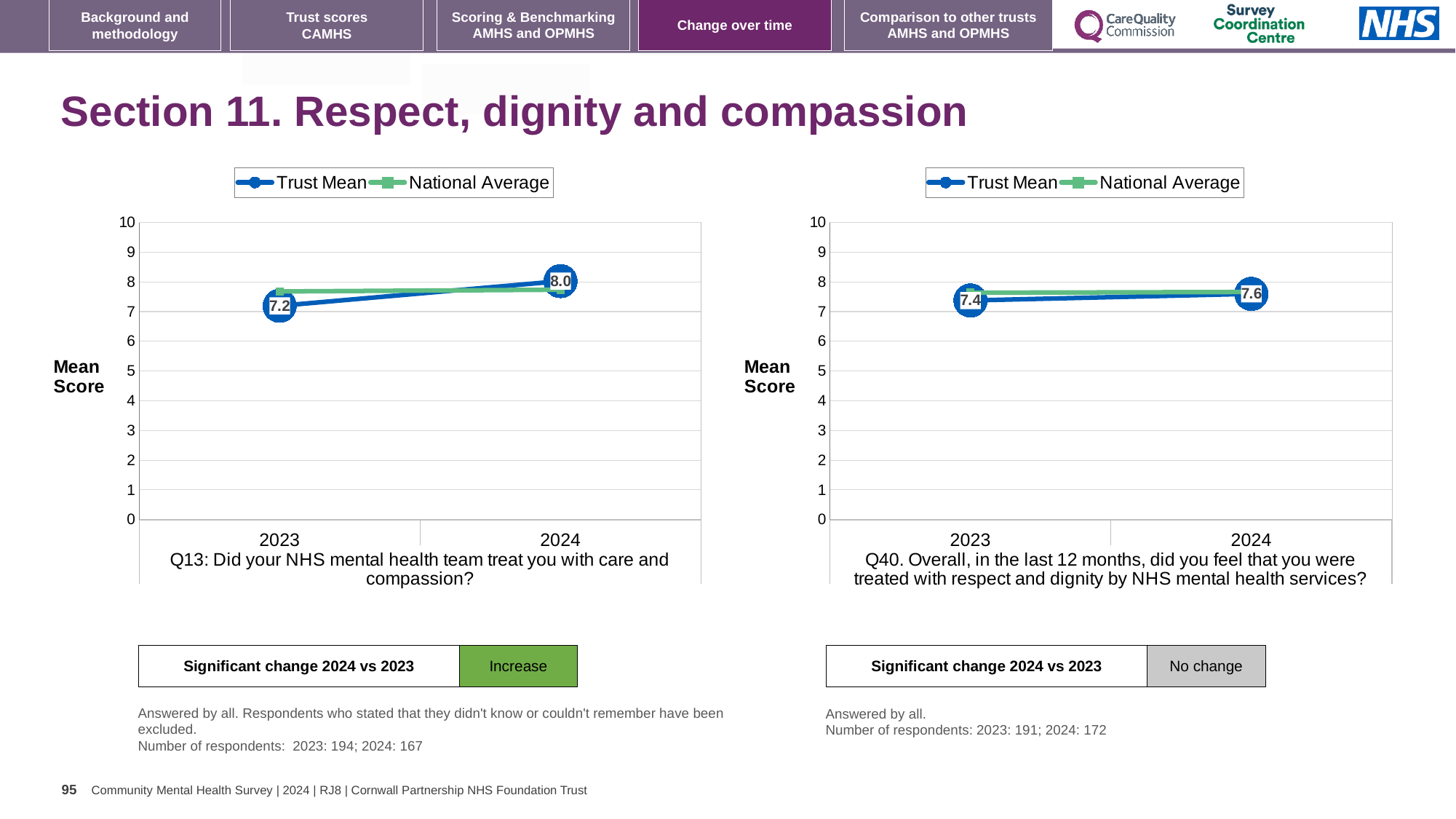
In the right chart (Q40), what is the difference between the Trust Mean for 2024 and 2023? 0.2 How many series does the legend of the left chart (Q13) list? 2 In the right chart (Q40), what is the Trust Mean score for 2024? 7.6 In the right chart (Q40), is the National Average for 2023 greater or less than 7? greater In the left chart (Q13), what is the Trust Mean score for 2023? 7.2 In the left chart (Q13), by how much did the Trust Mean change from 2023 to 2024? 0.8 How many years are plotted on the x axis of the right chart (Q40)? 2 What kind of chart is the right chart (Q40)? line chart In the left chart (Q13), does the Trust Mean rise or fall from 2023 to 2024? rise In the left chart (Q13), what is the Trust Mean score for 2024? 8.0 In the right chart (Q40), what is the Trust Mean score for 2023? 7.4 In the left chart (Q13), which year has the higher Trust Mean, 2023 or 2024? 2024